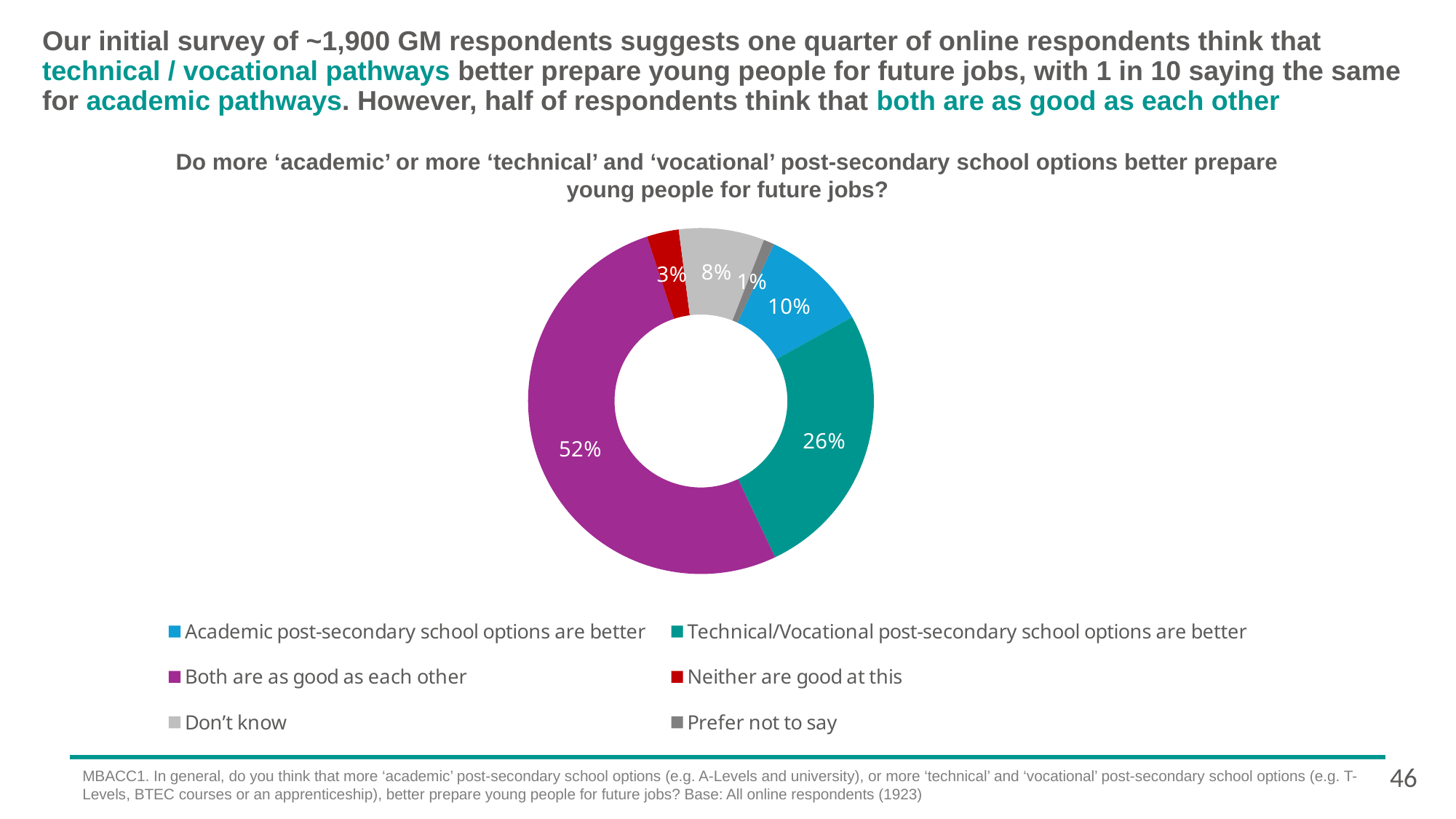
Which response has the smallest share of the chart? Prefer not to say What percentage of respondents said neither are good at this? 3% What percentage of respondents said both are as good as each other? 52% What type of chart is shown on the slide? Doughnut (pie) chart How many categories does the legend list? 6 Which response has the largest share of the chart? Both are as good as each other What colour represents 'Both are as good as each other' in the chart? Purple What percentage of respondents said academic post-secondary school options are better? 10% Which is larger: the share for 'Don't know' or the share for 'Neither are good at this'? Don't know What percentage of respondents said technical/vocational post-secondary school options are better? 26% What is the difference in percentage points between 'Technical/Vocational post-secondary school options are better' and 'Academic post-secondary school options are better'? 16 percentage points What percentage of respondents answered 'Don't know'? 8%